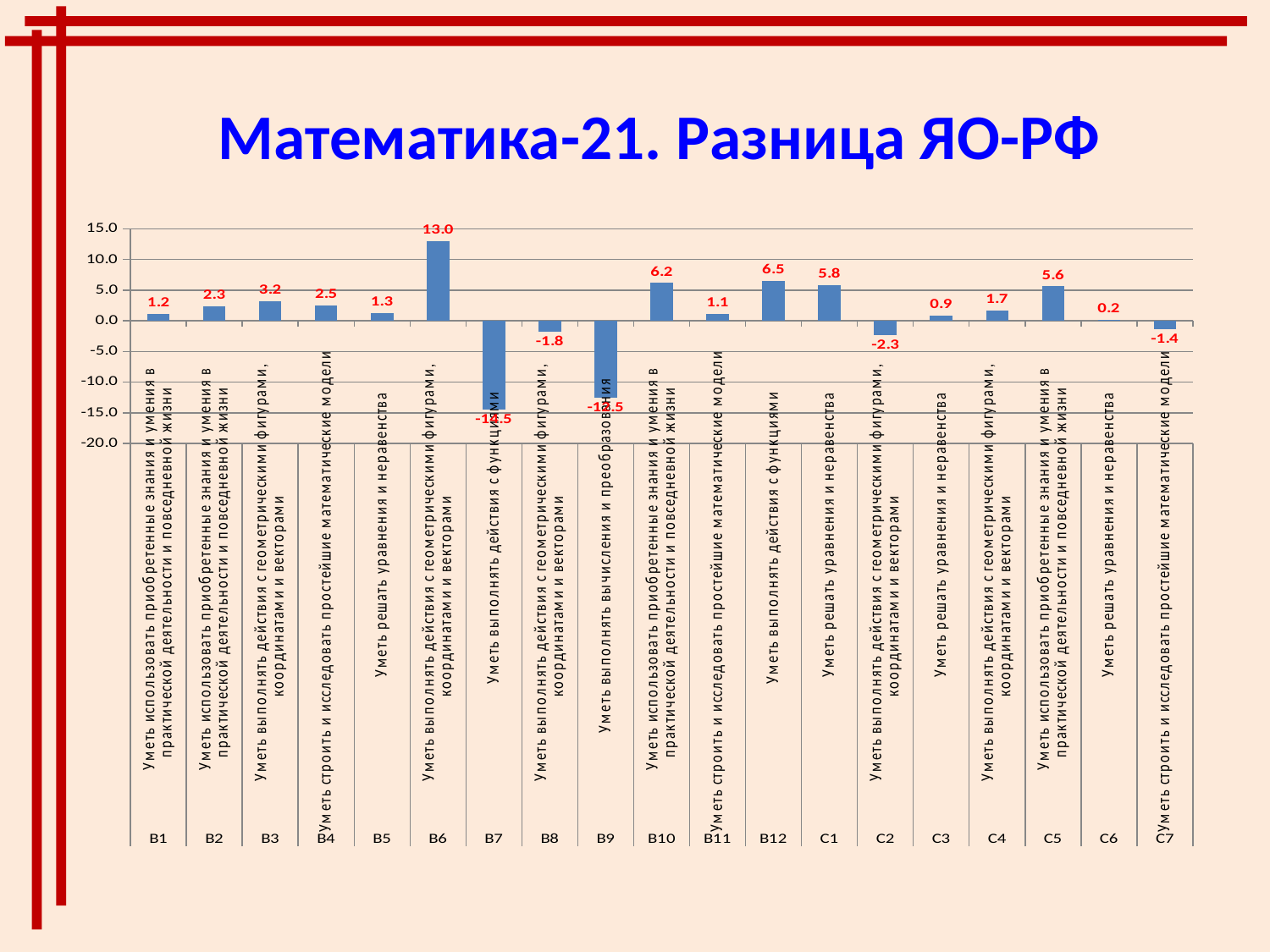
What kind of chart is shown on the slide? bar chart What is the title of the slide? Математика-21. Разница ЯО-РФ What is the value for C6? 0.2 What is the difference between the values for B6 and B12? 6.5 What is the value for C2? -2.3 What is the value for B6? 13.0 Is the value for B7 greater or less than -10.0? less Is the value for B9 greater or less than -5.0? less Which is larger, the value for B12 or the value for C1? B12 Which category has the highest value? B6 How many categories are shown on the x axis? 19 What is the value for B10? 6.2